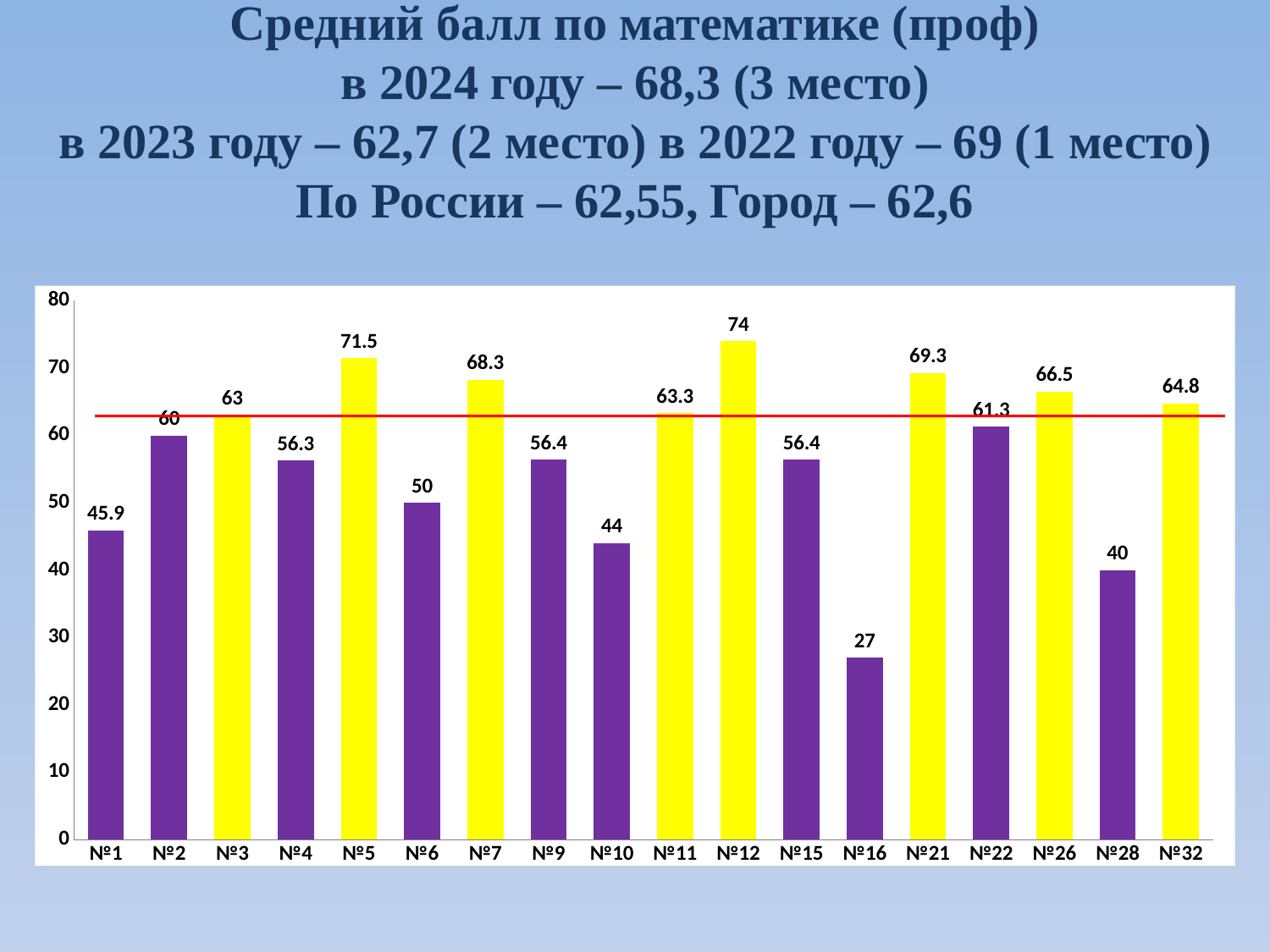
How many categories are shown on the x axis? 18 Which category has the highest value? №12 What colour are the bars for №3, №5, №7, №11, №12, №21, №26 and №32? yellow What kind of chart is shown on the slide? bar chart Which category has the lowest value? №16 What is the value for №12? 74 What is the difference between the values for №12 and №16? 47 What is the difference between the values for №5 and №6? 21.5 What is the value for №21? 69.3 Is the value for №28 greater or less than 50? less What is the value for №1? 45.9 Which is larger, the value for №7 or the value for №26? №7